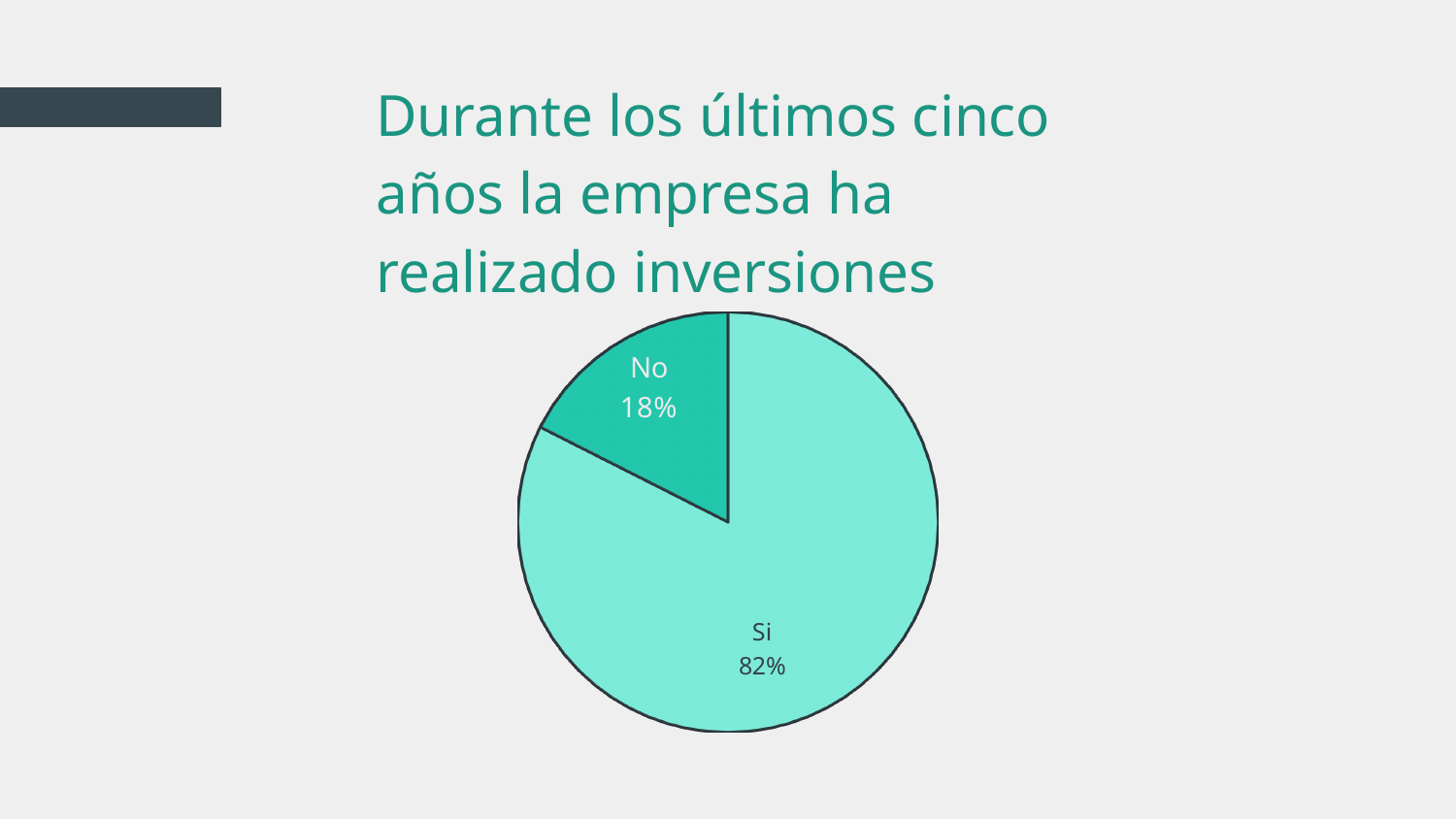
What percentage of the pie chart corresponds to "Si"? 82% Which is larger, the "Si" slice or the "No" slice? Si What type of chart is shown on the slide? Pie chart Which slice of the pie chart is the smallest? No What percentage of the pie chart corresponds to "No"? 18% How many slices does the pie chart have? 2 What is the difference in percentage points between the "Si" and "No" slices? 64 Which slice of the pie chart is shown in the darker teal colour? No What is the title of the slide above the chart? Durante los últimos cinco años la empresa ha realizado inversiones Which slice of the pie chart is the largest? Si What share of the pie does the "No" slice represent? 18%